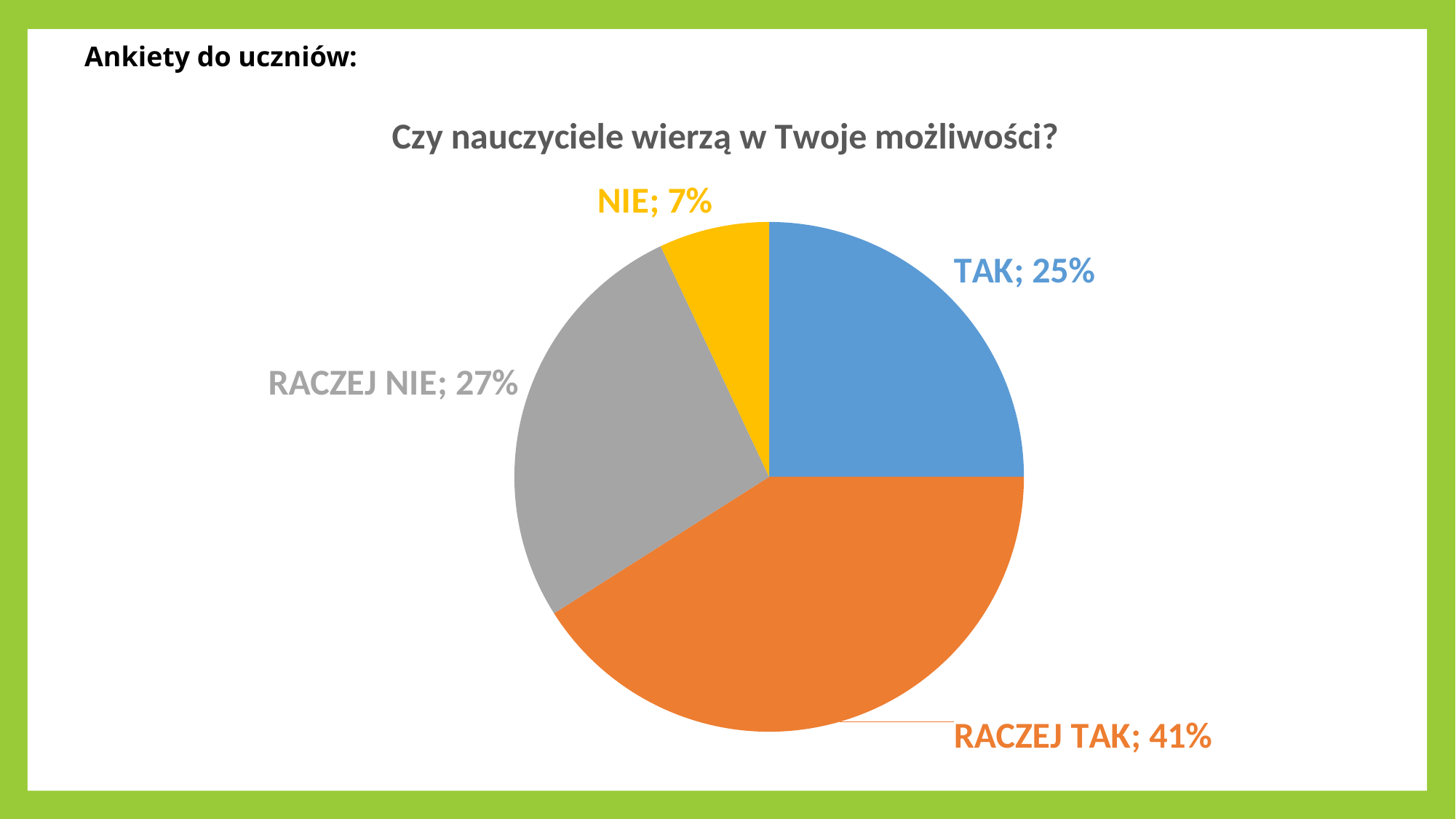
What percentage of students answered TAK? 25% What percentage of students answered RACZEJ NIE? 27% What type of chart is shown on the slide? Pie chart What is the title of the chart? Czy nauczyciele wierzą w Twoje możliwości? Which answer has the smallest share of the pie? NIE What percentage of students answered NIE? 7% Which answer has the largest share of the pie? RACZEJ TAK What colour is the slice for RACZEJ TAK? Orange How many answer categories are shown in the pie chart? 4 What percentage of students answered RACZEJ TAK? 41% Which is larger, the share for TAK or the share for RACZEJ NIE? RACZEJ NIE What is the difference in percentage points between RACZEJ TAK and RACZEJ NIE? 14